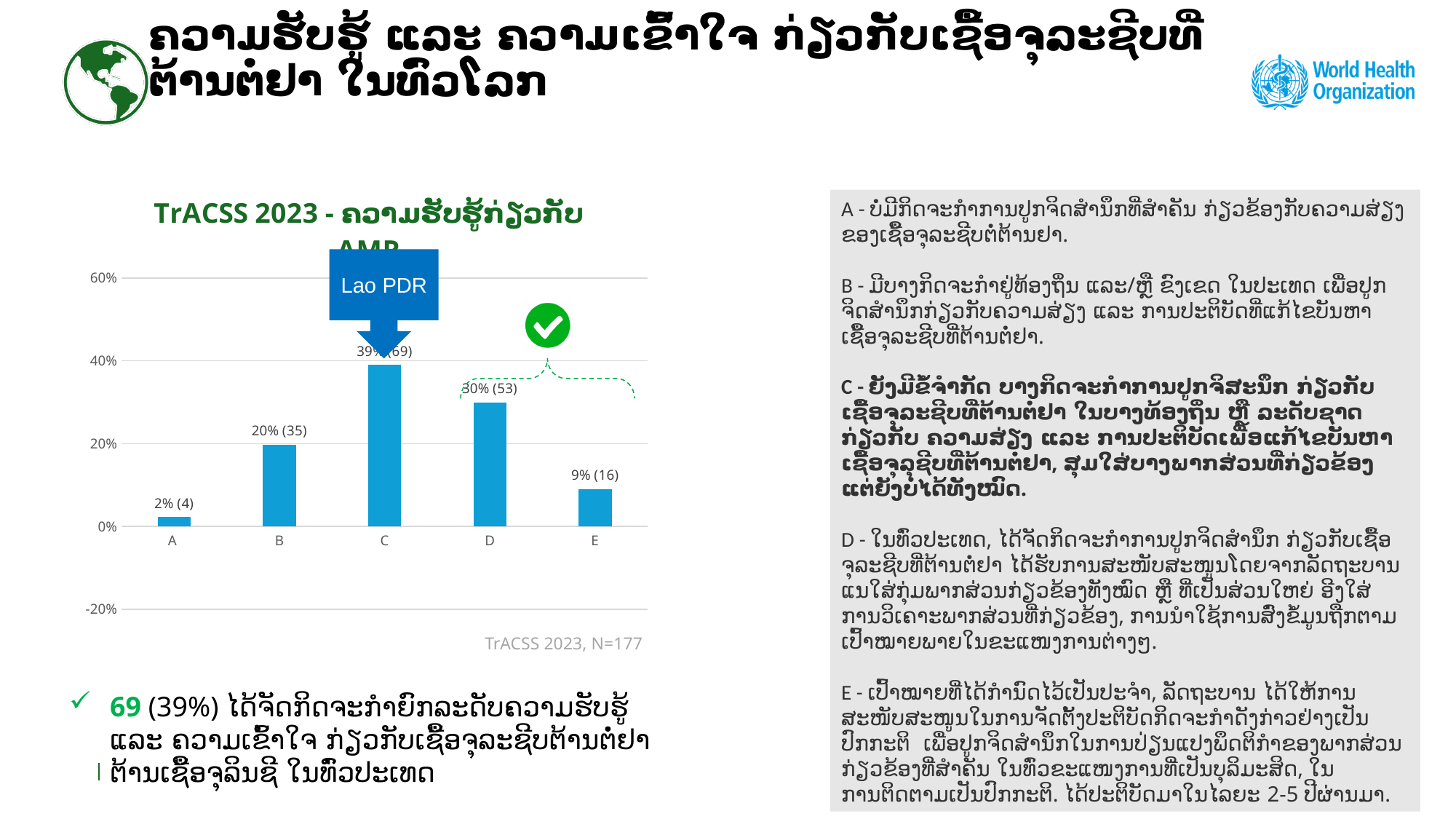
Which is larger, the value for category B or the value for category D? D How many categories are shown on the x axis? 5 Is the value for category D greater or less than 20%? greater What is the value shown for category E? 9% (16) What is the value shown for category A? 2% (4) Which category has the highest value? C What is the value shown for category B? 20% (35) Which category does the 'Lao PDR' callout point to? C What is the value shown for category C? 39% (69) What is the difference in percentage points between category C and category D? 9% Which category has the lowest value? A What kind of chart is shown on the slide? Bar chart